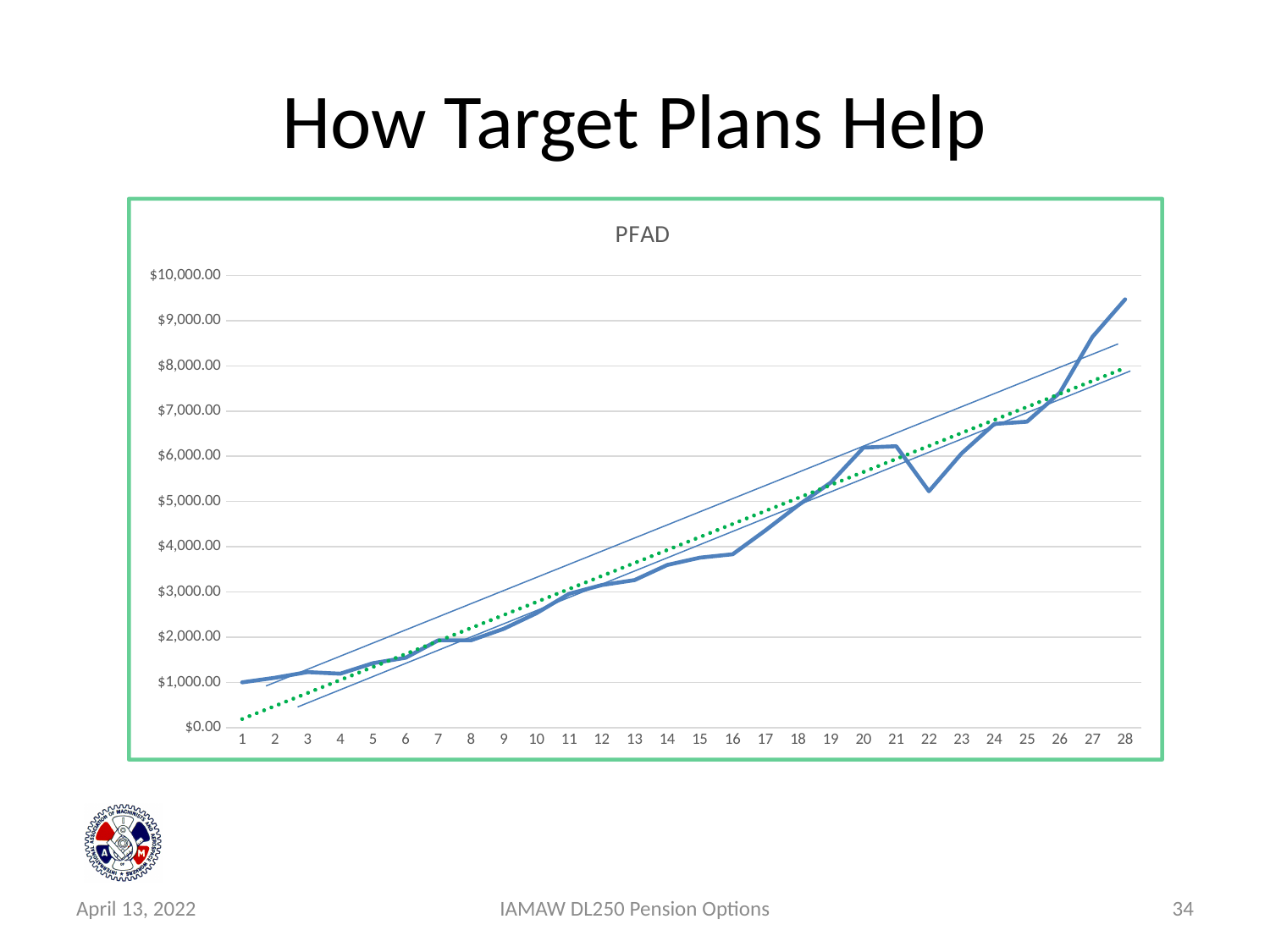
At which x-axis point does the thick blue line in the PFAD chart reach its highest value? 28 Which has the larger value on the thick blue line, point 21 or point 22? point 21 At which x-axis point does the thick blue line in the PFAD chart have its lowest value? 1 Is the value of the thick blue line at point 11 greater or less than $4,000.00? less Do the values of the thick blue line in the PFAD chart generally rise or fall from point 1 to point 28? rise Is the value of the thick blue line at point 22 greater or less than $6,000.00? less What is the title of the chart? PFAD What is the highest value labelled on the y axis of the PFAD chart? $10,000.00 Is the value of the thick blue line at point 28 greater or less than $9,000.00? greater What kind of chart is shown on the slide? line chart How many points are plotted along the x axis of the PFAD chart? 28